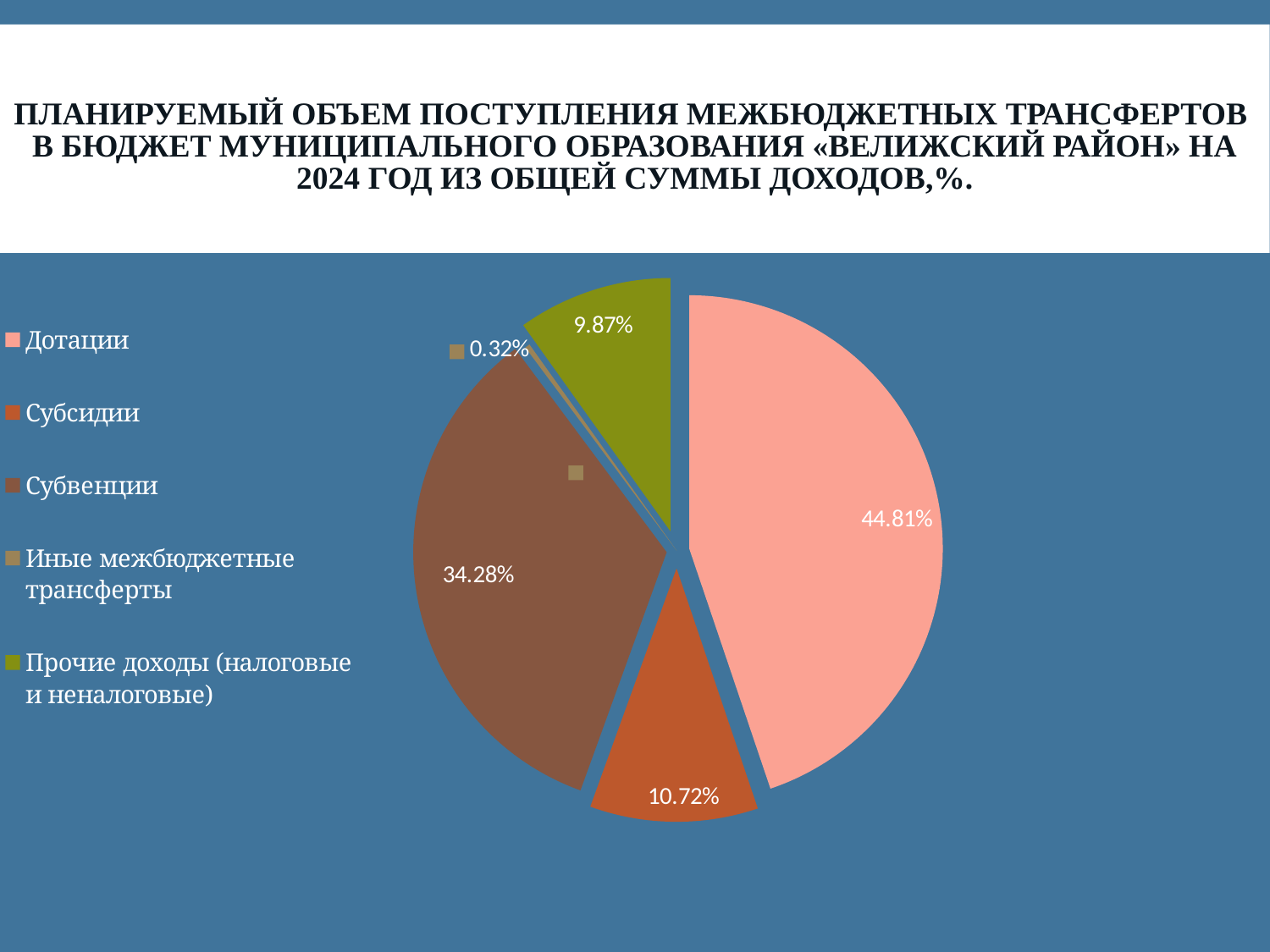
What is the value for Иные межбюджетные трансферты? 0.32% What is the difference between the shares of Дотации and Субвенции? 10.53% What is the value shown for Субвенции? 34.28% What type of chart is shown on the slide? Pie chart How many categories does the pie chart show? 5 Which category has the largest slice of the pie? Дотации What share is shown for Прочие доходы (налоговые и неналоговые)? 9.87% What share of the pie does Дотации account for? 44.81% What colour is the slice for Прочие доходы (налоговые и неналоговые)? Olive green What percentage is shown for Субсидии? 10.72% Which is larger, the share of Субсидии or the share of Прочие доходы (налоговые и неналоговые)? Субсидии Which category has the smallest slice of the pie? Иные межбюджетные трансферты